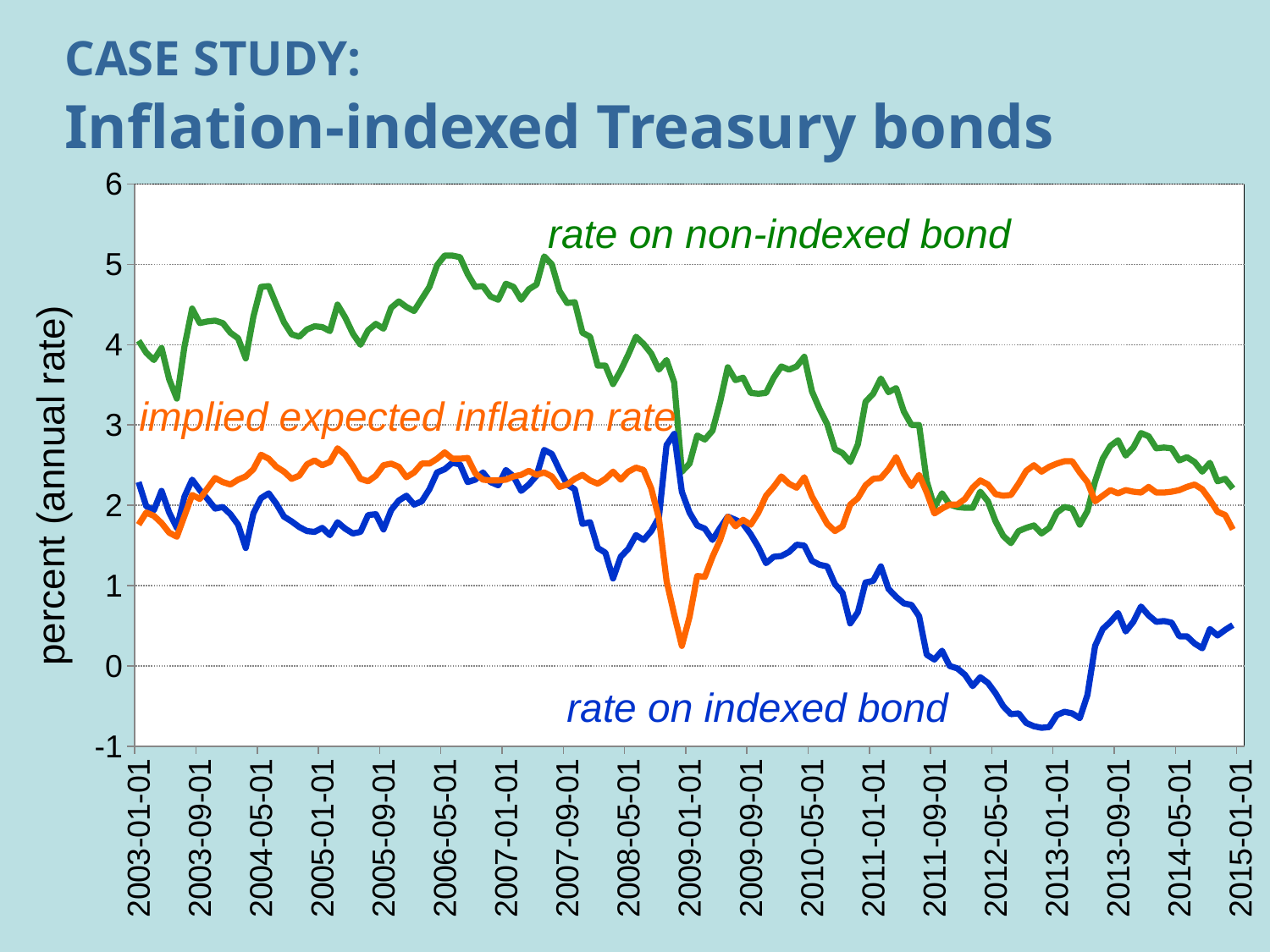
Which series is labelled in green on the chart? rate on non-indexed bond What is the label of the vertical axis? percent (annual rate) Is the rate on the indexed bond at 2012-09-01 greater or less than 0? less Which series reaches the highest value anywhere on the chart? rate on non-indexed bond At 2009-01-01, which is higher: the rate on the indexed bond or the implied expected inflation rate? rate on indexed bond Is the implied expected inflation rate at 2009-01-01 greater or less than 1? less Overall, does the rate on the indexed bond rise or fall from 2003-01-01 to 2015-01-01? fall Is the rate on the non-indexed bond at 2012-05-01 greater or less than 2? less How many series are plotted on the chart? 3 Which series is the lowest at 2013-01-01? rate on indexed bond What kind of chart is shown on the slide? line chart